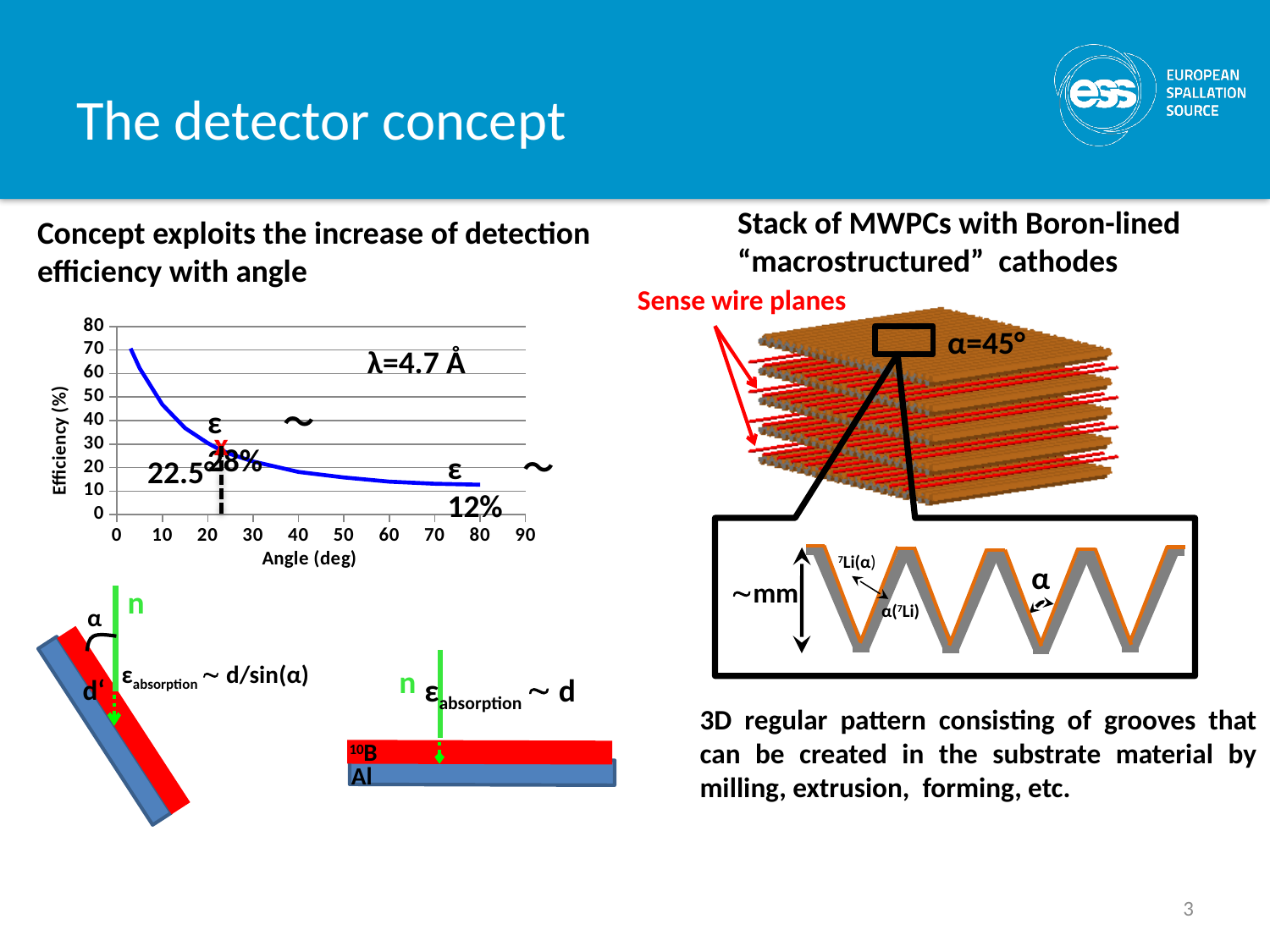
What is the label of the y axis of the efficiency chart? Efficiency (%) At which angle is the dashed vertical marker drawn in the efficiency chart? 22.5° In the efficiency chart, is the efficiency at an angle of 80 degrees greater or less than 20? less In the efficiency chart, is the efficiency at an angle of 60 degrees greater or less than 20? less What is the label of the x axis of the efficiency chart? Angle (deg) What kind of chart is shown on the left of the slide? line chart What is the highest tick value shown on the y axis of the efficiency chart? 80 In the efficiency chart, does the efficiency rise or fall as the angle increases? fall In the efficiency chart, is the efficiency at an angle of 5 degrees greater or less than 50? greater How many lines are plotted in the efficiency chart? 1 In the efficiency chart, which angle has the higher efficiency, 10 degrees or 70 degrees? 10 degrees